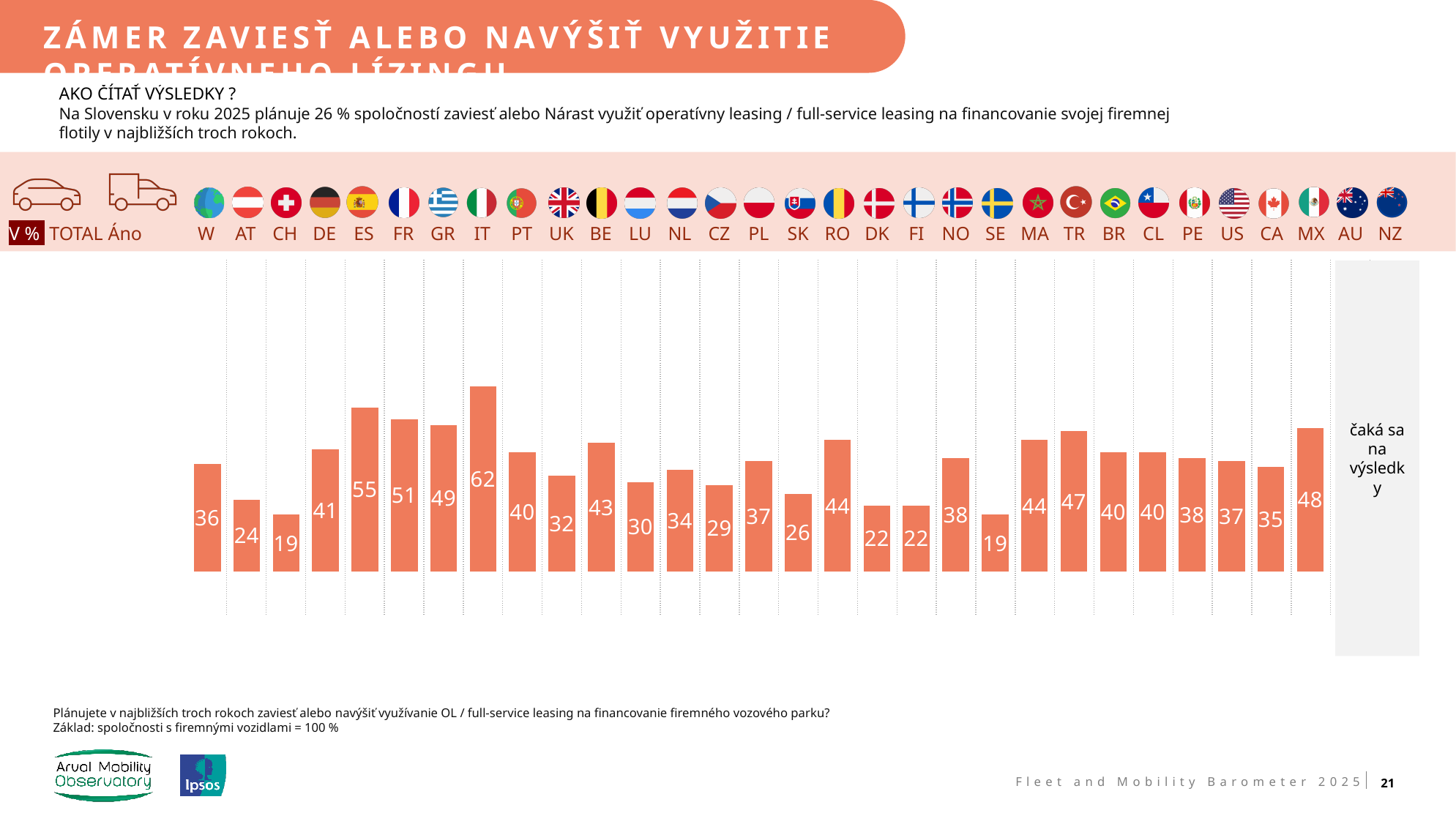
What is the difference between the values for ES and FR? 4 What is shown for AU and NZ instead of a bar? čaká sa na výsledky What is the value for MX? 48 Which is larger, the value for TR or the value for RO? TR What is the value for IT? 62 Which is larger, the value for AT or the value for UK? UK What is the difference between the values for IT and W? 26 Which country has the highest value? IT What is the value for SK? 26 How many countries have a bar with a value shown? 28 What is the value for ES? 55 What kind of chart is shown? bar chart